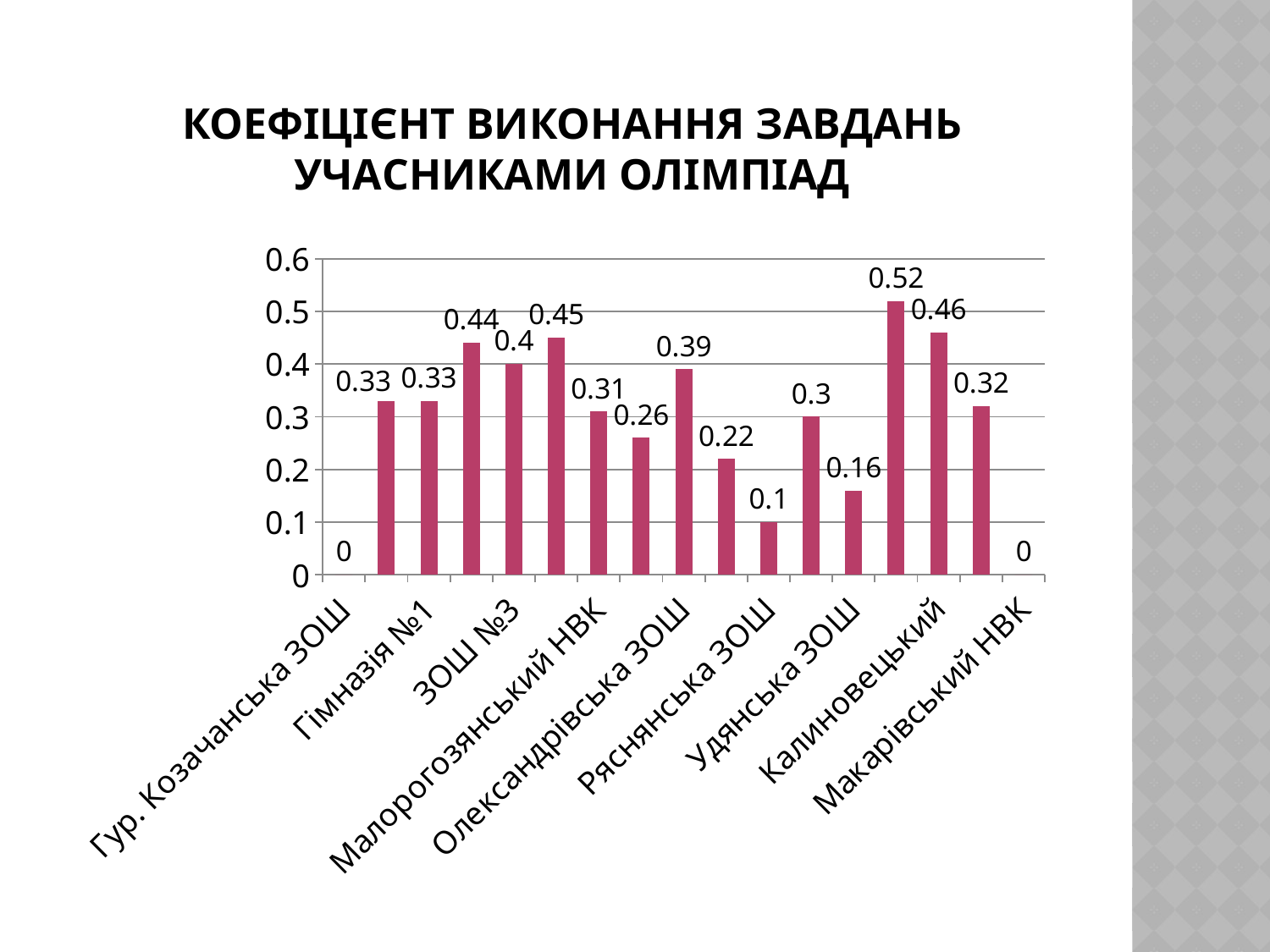
What is the value for ЗОШ №3? 0.4 How many bars (categories) are plotted on the chart? 17 Which has the larger value, Калиновецький or Гімназія №1? Калиновецький What is the value for Ряснянська ЗОШ? 0.1 What is the difference between the values for Калиновецький and Гімназія №1? 0.13 What is the value for Олександрівська ЗОШ? 0.39 What is the value for Малорогозянський НВК? 0.31 What is the value for Макарівський НВК? 0 What type of chart is shown on the slide? Bar chart What is the value for Калиновецький? 0.46 What is the value for Гімназія №1? 0.33 What is the highest value shown on the chart? 0.52